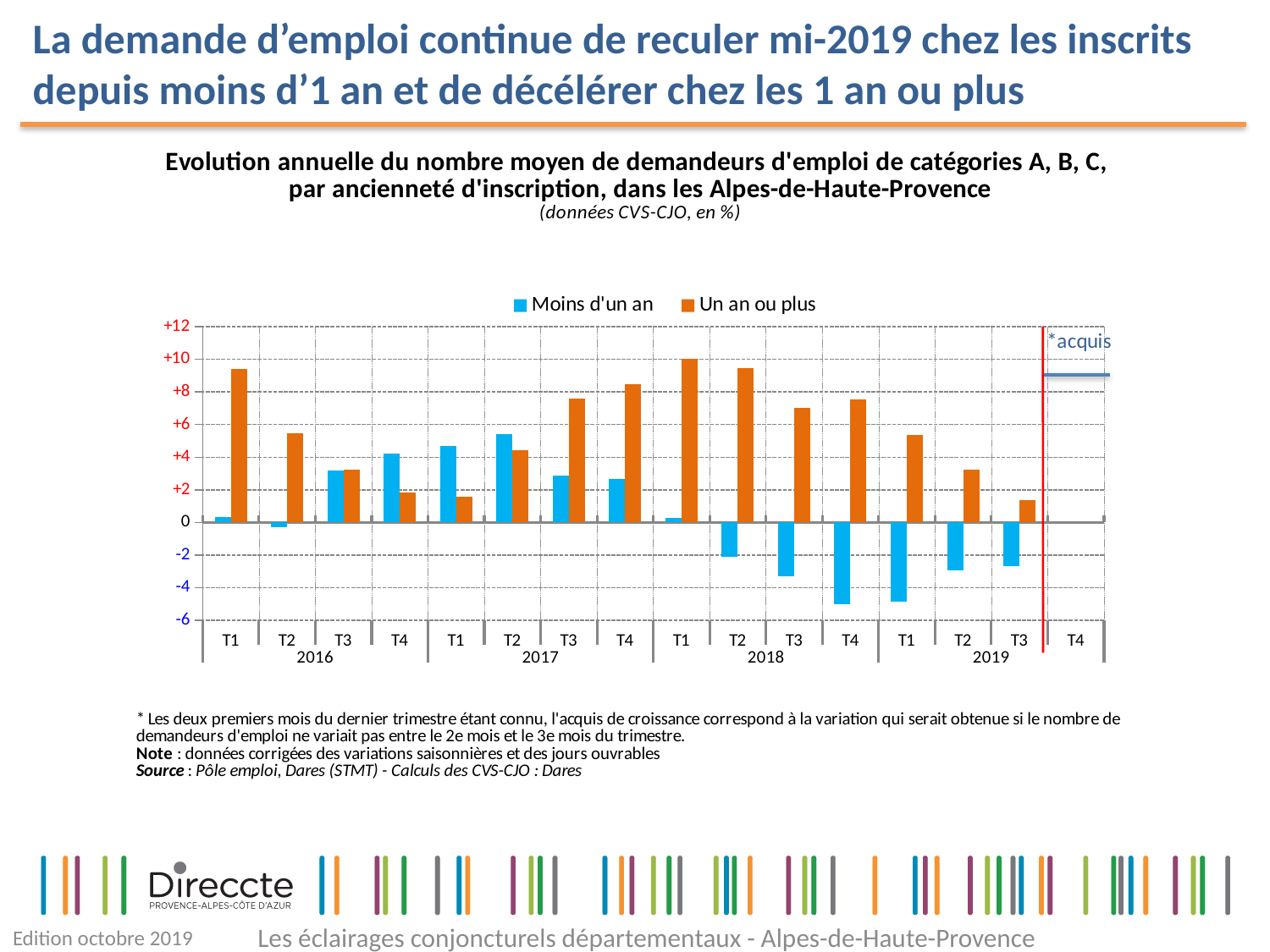
Is the value for 'Moins d'un an' in T4 2018 greater or less than -4? less How many series does the legend list? 2 What kind of chart is shown on the slide? bar chart Is the value for 'Un an ou plus' in T1 2016 greater or less than 8? greater In T1 2018, which series has the larger value, 'Moins d'un an' or 'Un an ou plus'? Un an ou plus How many quarters from T1 2016 to T3 2019 have bars plotted? 15 Is the value for 'Moins d'un an' in T2 2017 greater or less than 4? greater In which quarter does the 'Moins d'un an' series reach its highest value? T2 2017 Do the values for 'Un an ou plus' rise or fall from T1 2018 to T3 2019? fall Which series is shown in orange in the legend? Un an ou plus In T4 2016, which series has the larger value, 'Moins d'un an' or 'Un an ou plus'? Moins d'un an